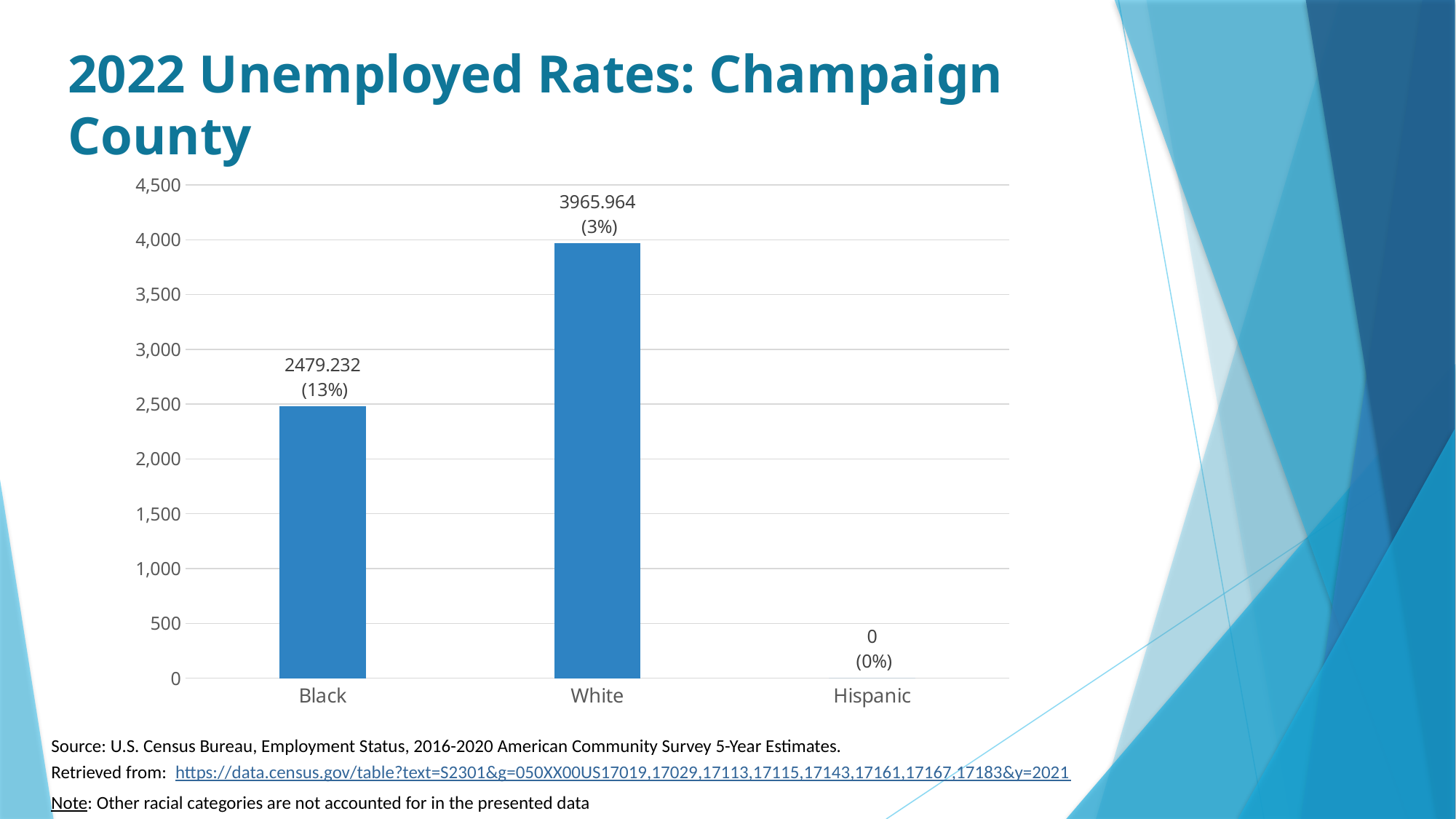
Is the value for Black greater or less than 2,000? greater Which category has the lowest value? Hispanic Which is larger, the value for Black or the value for White? White What kind of chart is shown on the slide? Bar chart What is the difference between the values for White and Black? 1486.732 What is the value shown for Black? 2479.232 What percentage is shown in parentheses for White? 3% What is the value shown for Hispanic? 0 Which category has the highest value? White What is the value shown for White? 3965.964 What percentage is shown in parentheses for Black? 13% How many categories are shown on the x axis? 3